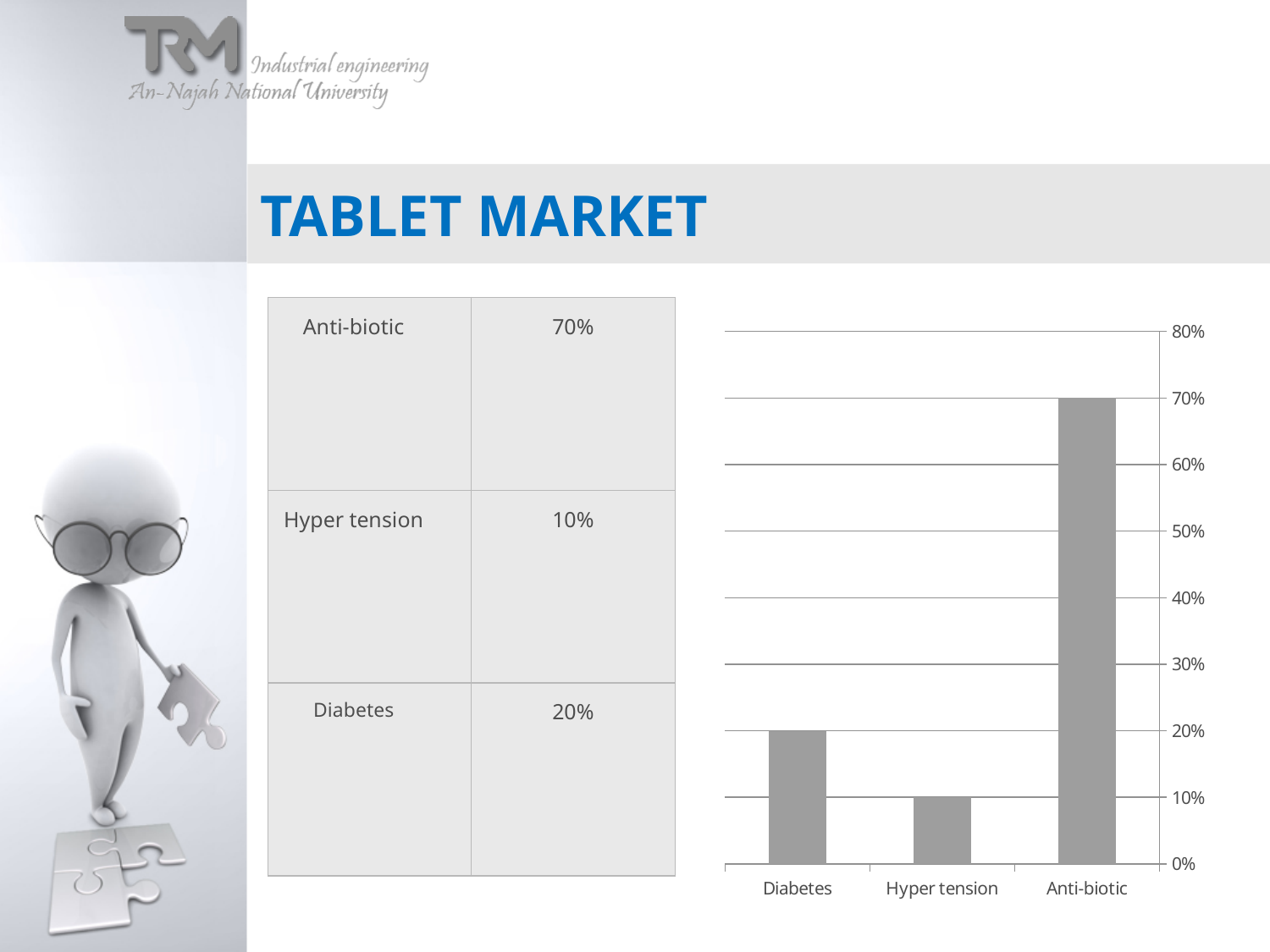
How many categories are plotted on the bar chart? 3 What is the value for Diabetes on the bar chart? 20% What is the difference between the values for Diabetes and Hyper tension? 10% What is the value for Anti-biotic on the bar chart? 70% Which category has the lowest value on the bar chart? Hyper tension What kind of chart is shown on the slide? bar chart Which is larger, the value for Diabetes or the value for Hyper tension? Diabetes Which category has the highest value on the bar chart? Anti-biotic What is the value for Hyper tension on the bar chart? 10% What is the difference between the values for Anti-biotic and Diabetes? 50% What is the highest value shown on the vertical axis of the bar chart? 80% Is the value for Anti-biotic greater or less than 50%? greater